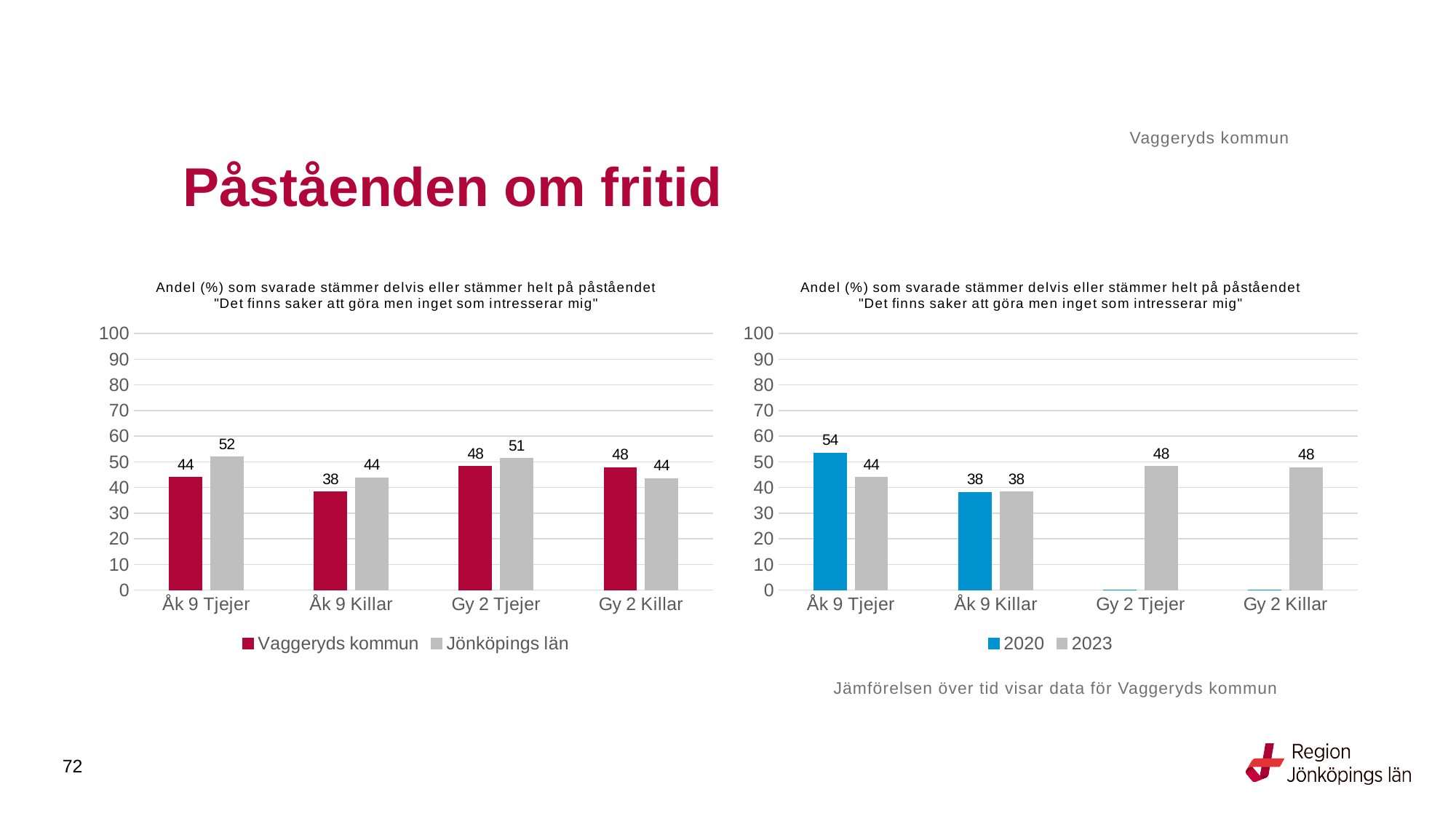
In the right chart, what is the difference between 2020 and 2023 for Åk 9 Tjejer? 10 How many categories are shown on the x axis of the left chart? 4 What type of chart is the right chart? Bar chart In the right chart, how many series does the legend list? 2 In the left chart, which is larger for Gy 2 Killar: Vaggeryds kommun or Jönköpings län? Vaggeryds kommun In the left chart, which category has the highest value for Jönköpings län? Åk 9 Tjejer In the right chart, what is the value for 2023 for Gy 2 Killar? 48 In the left chart, which category has the lowest value for Vaggeryds kommun? Åk 9 Killar In the left chart, what is the difference between Jönköpings län and Vaggeryds kommun for Åk 9 Tjejer? 8 In the left chart, what is the value for Jönköpings län for Gy 2 Tjejer? 51 In the left chart, what is the value for Vaggeryds kommun for Åk 9 Tjejer? 44 In the right chart, what is the value for 2020 for Åk 9 Tjejer? 54